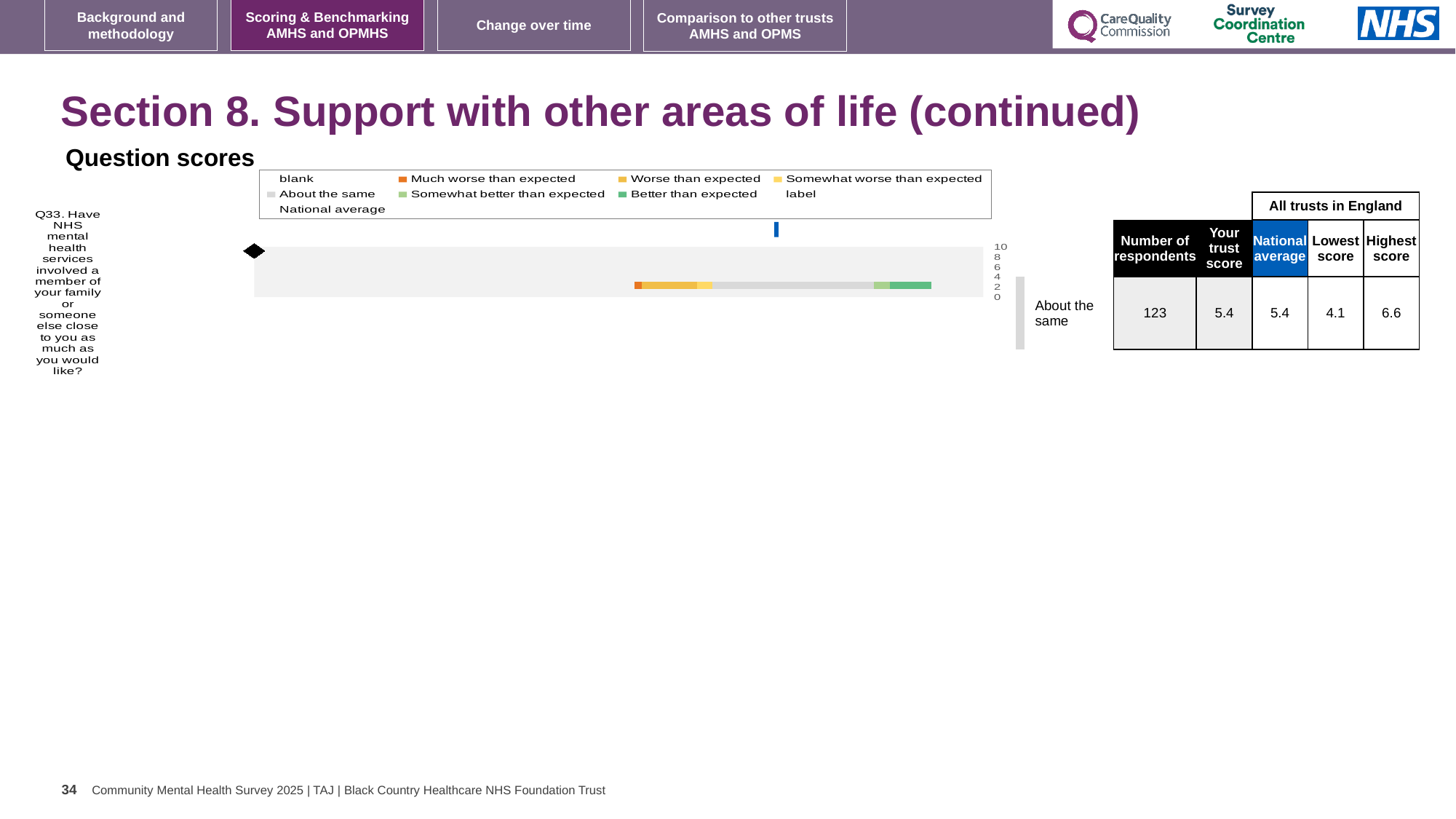
How many questions are plotted in the Question scores chart? 1 Which colour does the legend use for 'Better than expected'? green What is the lowest score among all trusts in England for Q33? 4.1 Which question is plotted in the Question scores chart? Q33 What is the trust score for Q33? 5.4 What is the difference between the highest score and the lowest score for Q33? 2.5 What is the highest score among all trusts in England for Q33? 6.6 What kind of chart is shown under 'Question scores'? bar chart What is the difference between the highest score and the trust score for Q33? 1.2 How is the trust's score for Q33 categorised relative to expectation? About the same How many respondents are shown for Q33? 123 What is the national average for Q33? 5.4